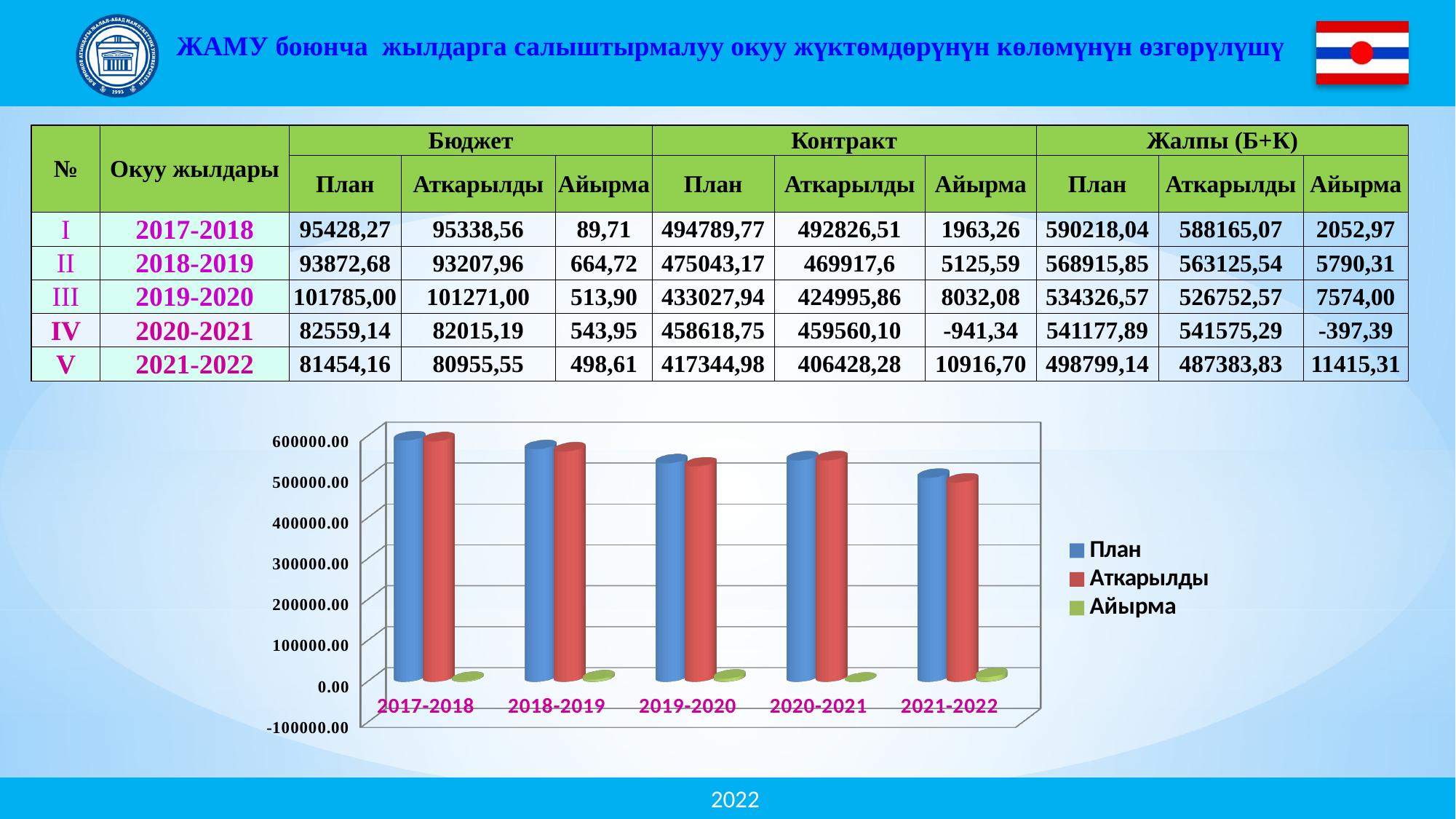
According to the table, what is the Жалпы (Б+К) План value for 2017-2018 that is plotted in the chart? 590218,04 In which academic year is the План bar highest in the chart? 2017-2018 According to the table, what is the Жалпы (Б+К) Аткарылды value for 2021-2022 that is plotted in the chart? 487383,83 What kind of chart is shown on the slide? bar chart Is the Айырма value for 2021-2022 in the chart greater or less than 100000.00? less Which is larger in the chart: the План bar for 2018-2019 or the План bar for 2019-2020? 2018-2019 How many series does the chart legend list? 3 What are the three series named in the chart legend? План, Аткарылды, Айырма How many academic years (categories) are shown on the x axis of the chart? 5 Is the План value for 2019-2020 in the chart greater or less than 500000.00? greater Do the План bars rise or fall overall from 2017-2018 to 2021-2022? fall In which academic year is the План bar lowest in the chart? 2021-2022